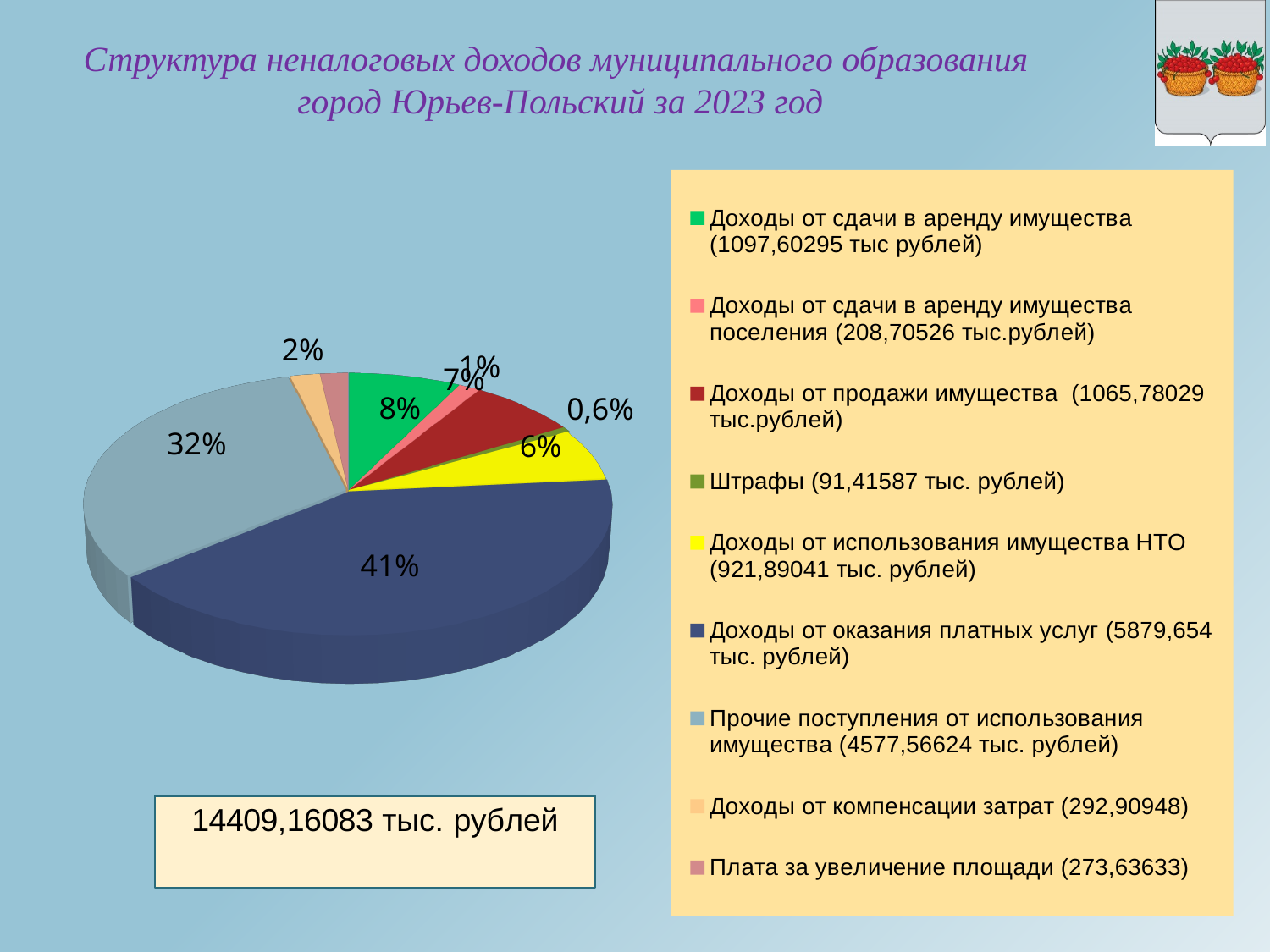
How many categories does the legend of the pie chart list? 9 Which category has the smallest share of the pie? Штрафы What share of the pie is labelled for Доходы от сдачи в аренду имущества (green slice)? 8% What share of the pie is labelled for Доходы от использования имущества НТО (yellow slice)? 6% Which category has the largest share of the pie? Доходы от оказания платных услуг Which is larger: the share for Доходы от оказания платных услуг or the share for Прочие поступления от использования имущества? Доходы от оказания платных услуг What kind of chart is shown on the slide? pie chart What share of the pie is labelled for Доходы от оказания платных услуг? 41% What is the difference in percentage points between the share for Доходы от оказания платных услуг (41%) and the share for Прочие поступления от использования имущества (32%)? 9% What amount is given in the legend for Доходы от оказания платных услуг? 5879,654 тыс. рублей